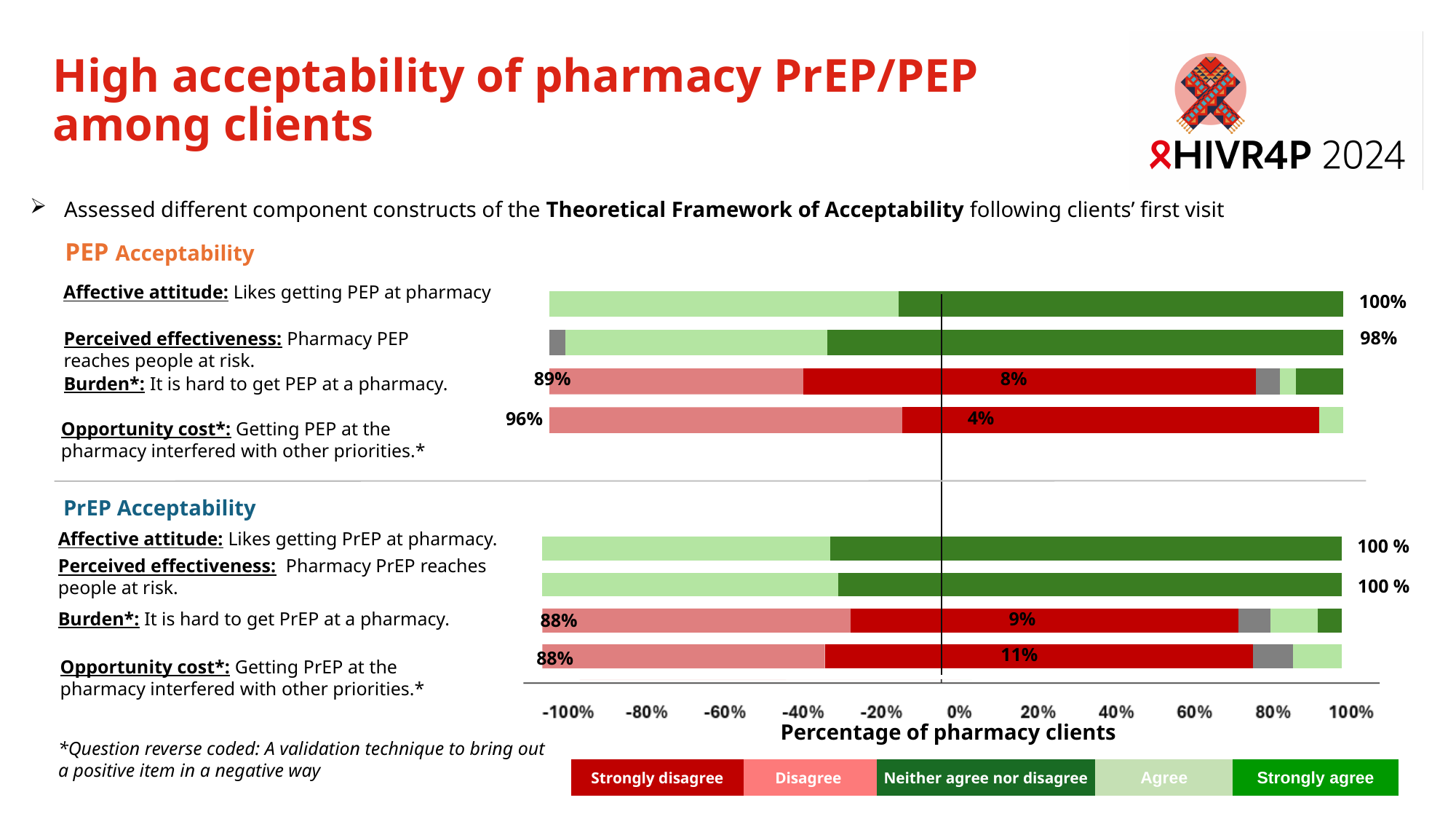
What percentage is labelled on the left (disagree) side of the PEP 'Opportunity cost' bar? 96% What percentage is labelled for the PEP 'Perceived effectiveness' bar? 98% What is the title of the x axis? Percentage of pharmacy clients What percentage is labelled for the PrEP 'Perceived effectiveness' bar? 100 % What kind of chart is shown on the slide? bar chart How many acceptability items (bars) are shown in the PEP Acceptability section? 4 What is the difference between the disagree percentage for PEP 'Opportunity cost' (96%) and PrEP 'Opportunity cost' (88%)? 8 percentage points What percentage is labelled on the left (disagree) side of the PrEP 'Burden' bar? 88% What percentage is labelled for the PEP 'Affective attitude: Likes getting PEP at pharmacy' bar? 100% What percentage is labelled inside the red portion of the PrEP 'Opportunity cost' bar? 11% What percentage is labelled on the left (disagree) side of the PEP 'Burden' bar? 89% How many response categories does the legend list? 5